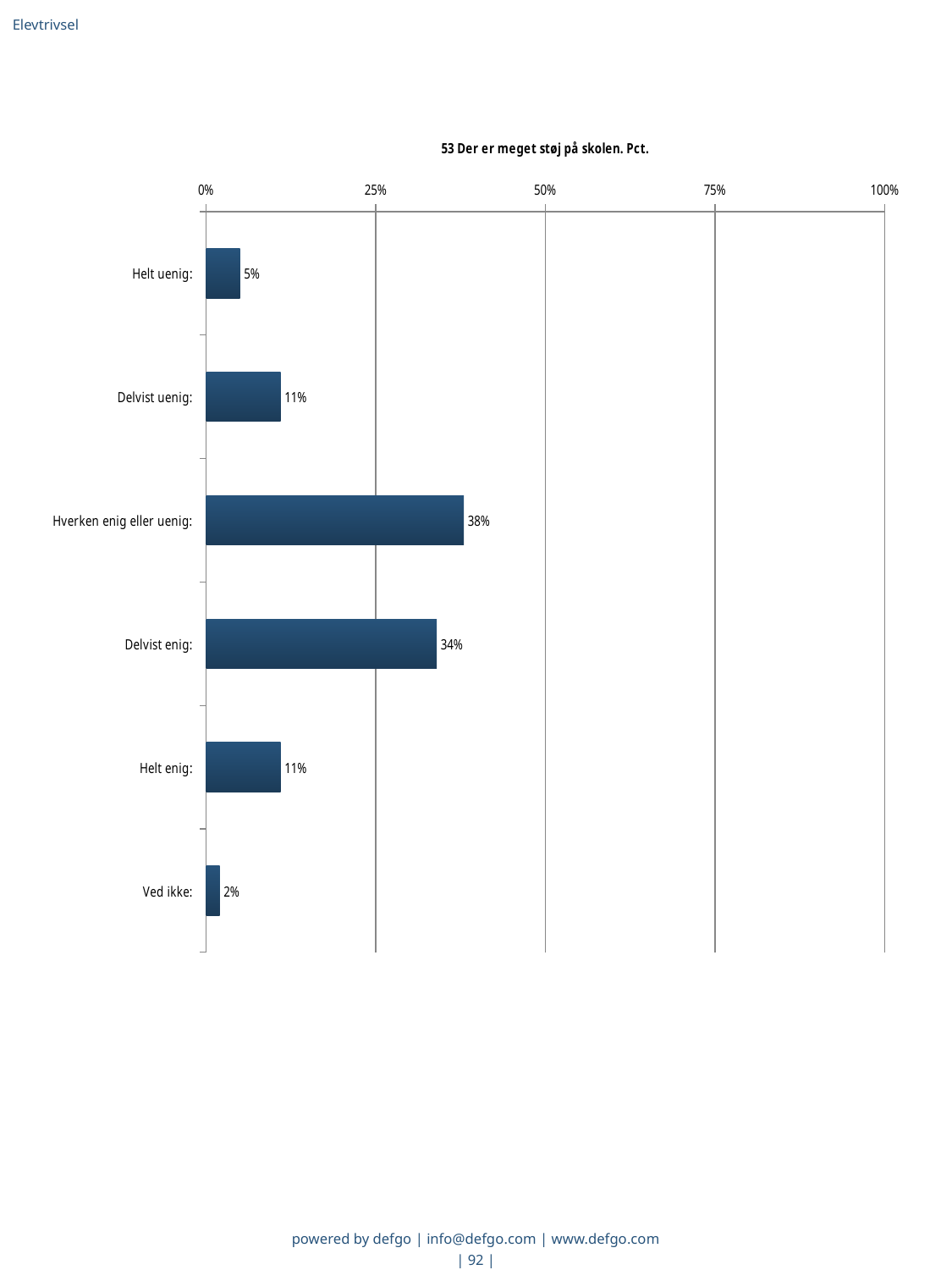
Is the value for "Delvist enig" greater or less than 25%? greater Which category has the lowest value? Ved ikke How many categories are shown in the chart? 6 What is the title of the chart? 53 Der er meget støj på skolen. Pct. What kind of chart is shown on the slide? Bar chart What is the difference between the values for "Hverken enig eller uenig" and "Delvist enig"? 4% What is the value for "Hverken enig eller uenig"? 38% What is the value for "Delvist enig"? 34% Which category has the highest value? Hverken enig eller uenig What is the value for "Helt uenig"? 5% Which is larger, the value for "Delvist uenig" or the value for "Helt uenig"? Delvist uenig What is the value for "Ved ikke"? 2%